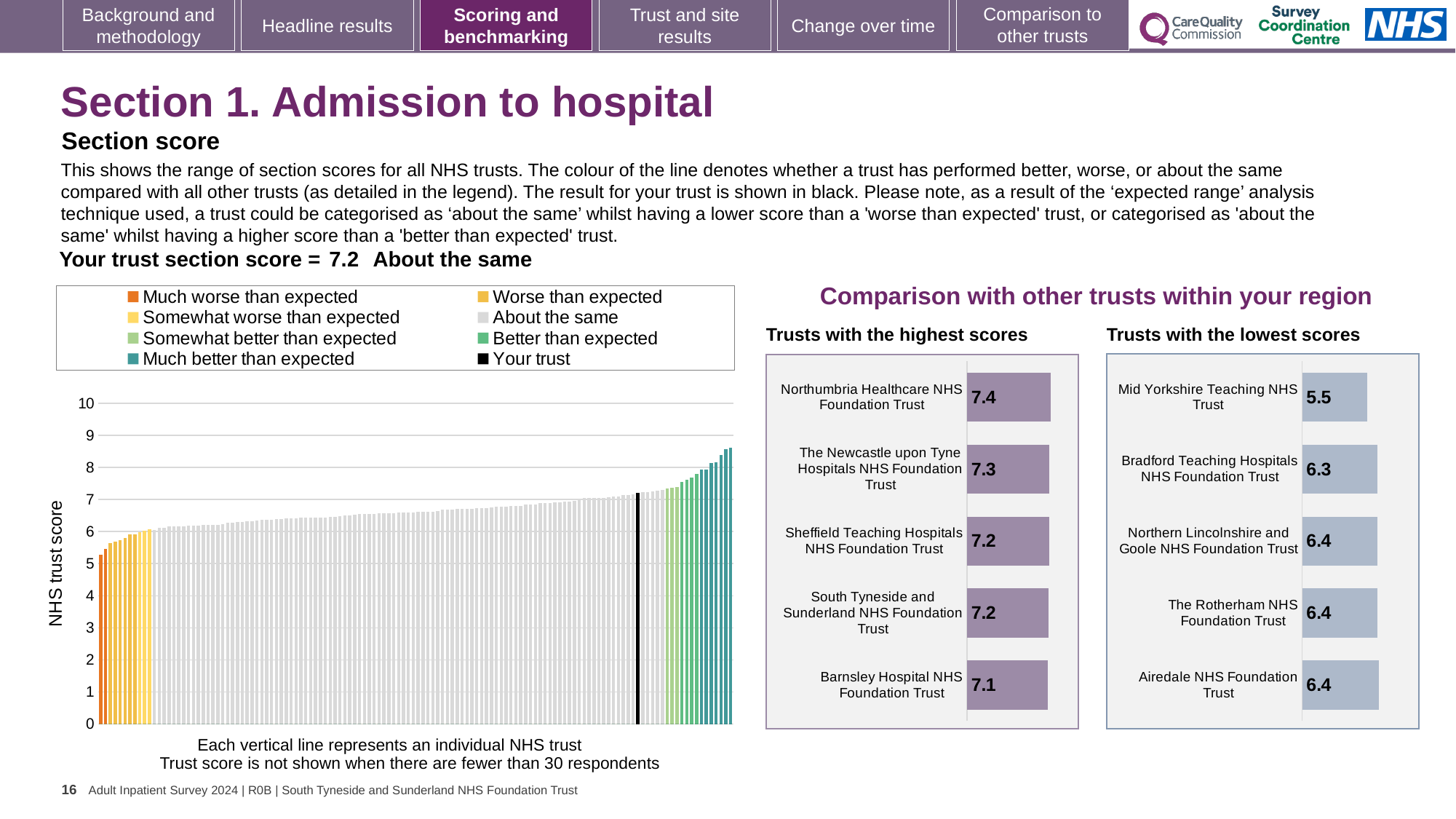
In the 'Trusts with the highest scores' chart, which has the higher score: The Newcastle upon Tyne Hospitals NHS Foundation Trust or Sheffield Teaching Hospitals NHS Foundation Trust? The Newcastle upon Tyne Hospitals NHS Foundation Trust How many trusts are shown in the 'Trusts with the highest scores' chart? 5 In the 'Trusts with the highest scores' chart, what is the score for Northumbria Healthcare NHS Foundation Trust? 7.4 What kind of chart is the large 'NHS trust score' chart on the left of the slide? Bar chart In the 'Trusts with the lowest scores' chart, what is the score for Mid Yorkshire Teaching NHS Trust? 5.5 In the 'Trusts with the highest scores' chart, which trust has the highest score? Northumbria Healthcare NHS Foundation Trust In the 'Trusts with the lowest scores' chart, which trust has the lowest score? Mid Yorkshire Teaching NHS Trust In the large 'NHS trust score' chart, is the value of the lowest-scoring trust (the leftmost bar) greater or less than 6? less According to the slide, what is your trust's section score for Admission to hospital? 7.2 In the 'Trusts with the lowest scores' chart, how much higher is Bradford Teaching Hospitals NHS Foundation Trust's score than Mid Yorkshire Teaching NHS Trust's score? 0.8 In the 'Trusts with the highest scores' chart, what is the difference between the scores of Northumbria Healthcare NHS Foundation Trust and Barnsley Hospital NHS Foundation Trust? 0.3 How many entries does the legend of the large 'NHS trust score' chart list? 8